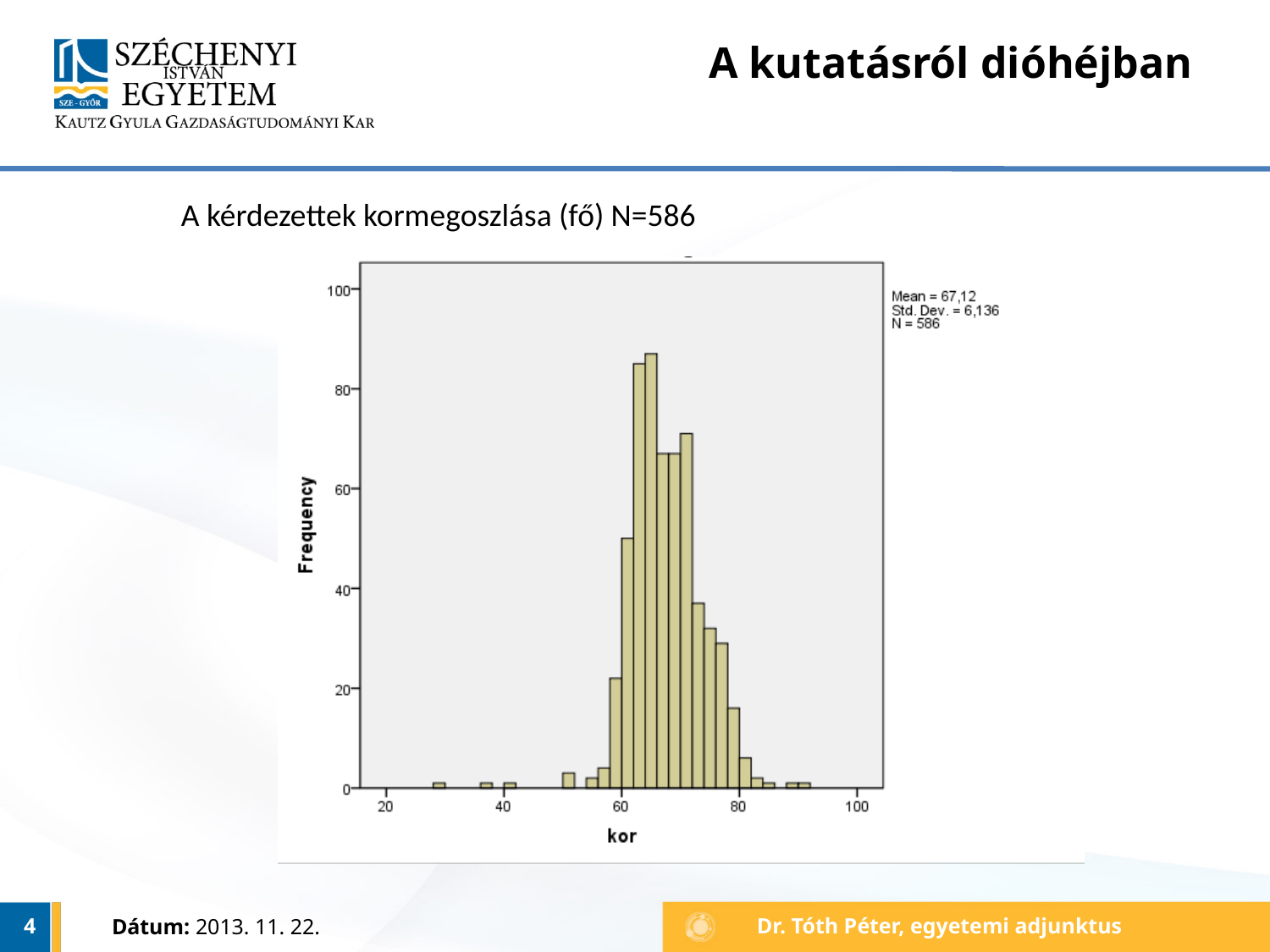
What is the label of the horizontal axis? kor What kind of chart is shown on the slide? bar chart (histogram) What is the label of the vertical axis? Frequency Is the frequency of the tallest bar greater or less than 100? less What is the standard deviation printed next to the chart? 6,136 Is the frequency of the tallest bar greater or less than 80? greater What is the highest tick value shown on the horizontal axis? 100 What is the mean value printed next to the chart? 67,12 What is the value of N printed next to the chart? 586